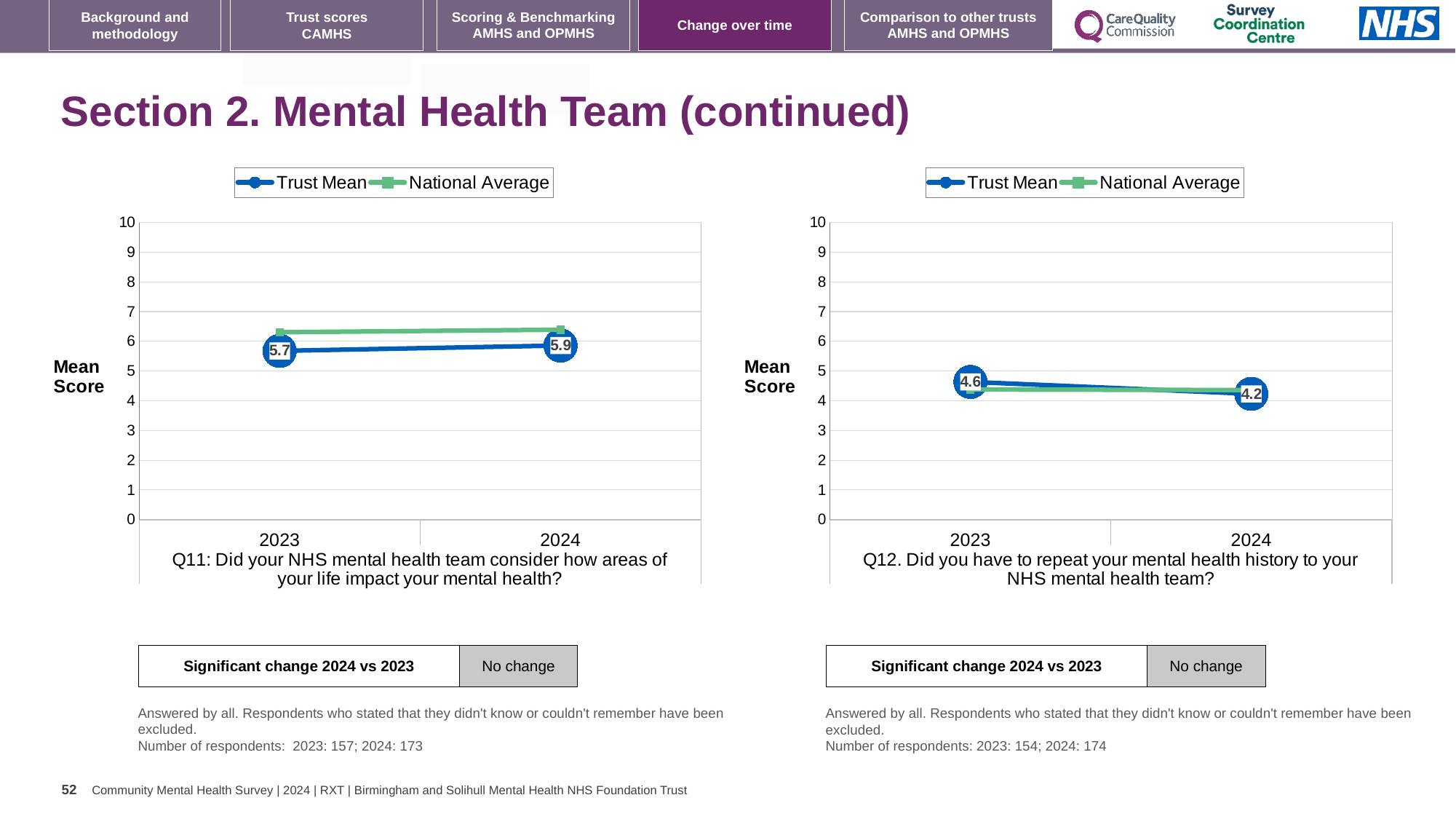
In the Q11 chart (left), which is higher in 2023, the Trust Mean or the National Average? National Average In the Q11 chart (left), does the Trust Mean rise or fall from 2023 to 2024? rise In the Q11 chart (left), by how much did the Trust Mean change from 2023 to 2024? 0.2 How many series does the legend of the Q12 chart (right) list? 2 In the Q12 chart (right), what is the Trust Mean score for 2024? 4.2 In the Q11 chart (left), what is the Trust Mean score for 2024? 5.9 In the Q11 chart (left), what is the Trust Mean score for 2023? 5.7 In the Q12 chart (right), by how much did the Trust Mean change from 2023 to 2024? 0.4 In the Q11 chart (left), is the National Average for 2024 greater or less than 6? greater In the Q12 chart (right), what is the Trust Mean score for 2023? 4.6 What kind of chart is the Q11 chart (left)? line chart In the Q12 chart (right), does the Trust Mean rise or fall from 2023 to 2024? fall